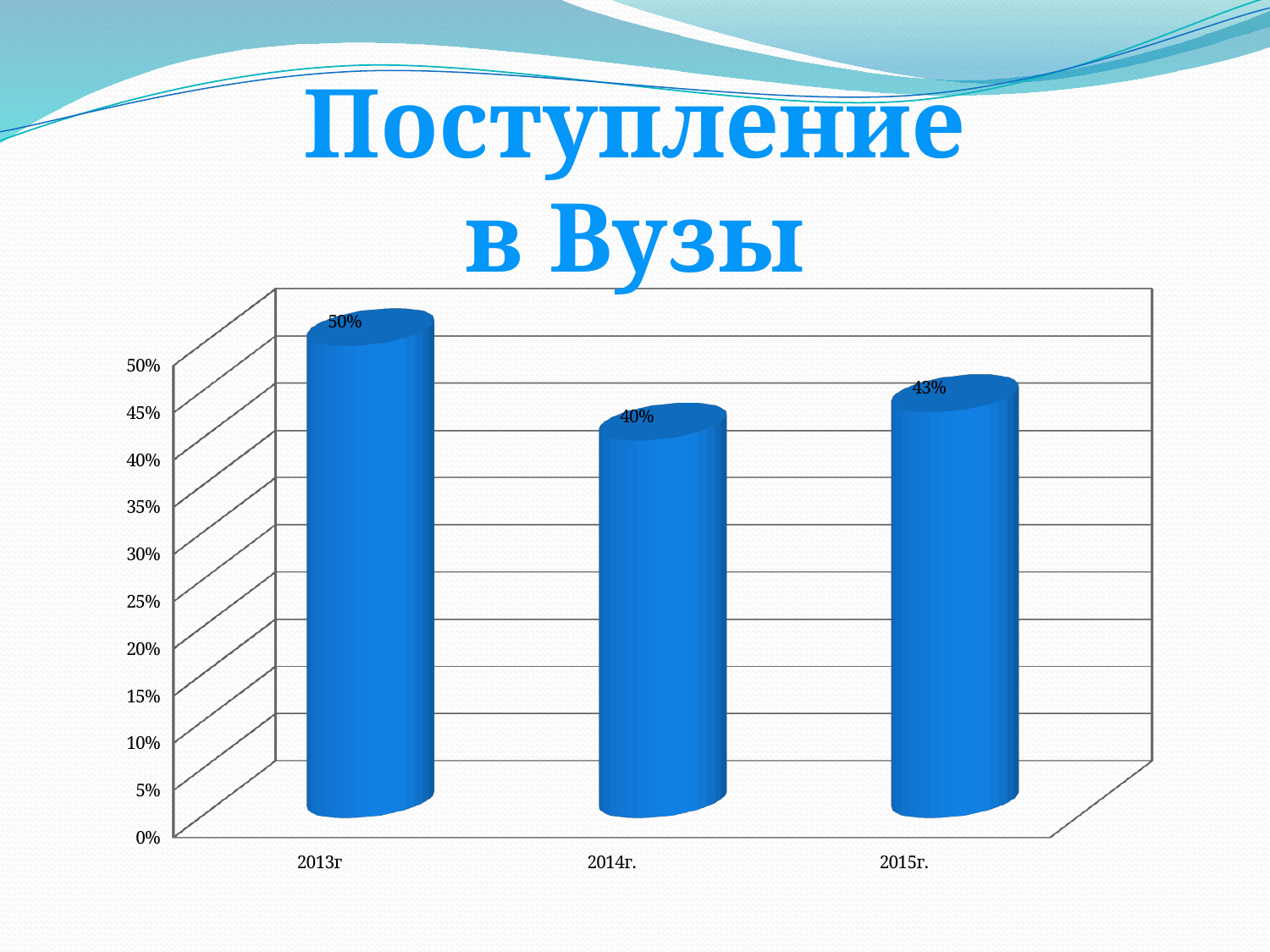
Does the value rise or fall from 2013г to 2014г.? fall What is the value for 2014г.? 40% What is the value for 2015г.? 43% How many categories are shown on the x axis? 3 Which is larger, the value for 2014г. or the value for 2015г.? 2015г. What kind of chart is shown on the slide? bar chart What is the title of the slide? Поступление в Вузы Which year has the lowest value? 2014г. What is the value for 2013г? 50% What is the difference between the values for 2015г. and 2014г.? 3% Which year has the highest value? 2013г What is the difference between the values for 2013г and 2014г.? 10%